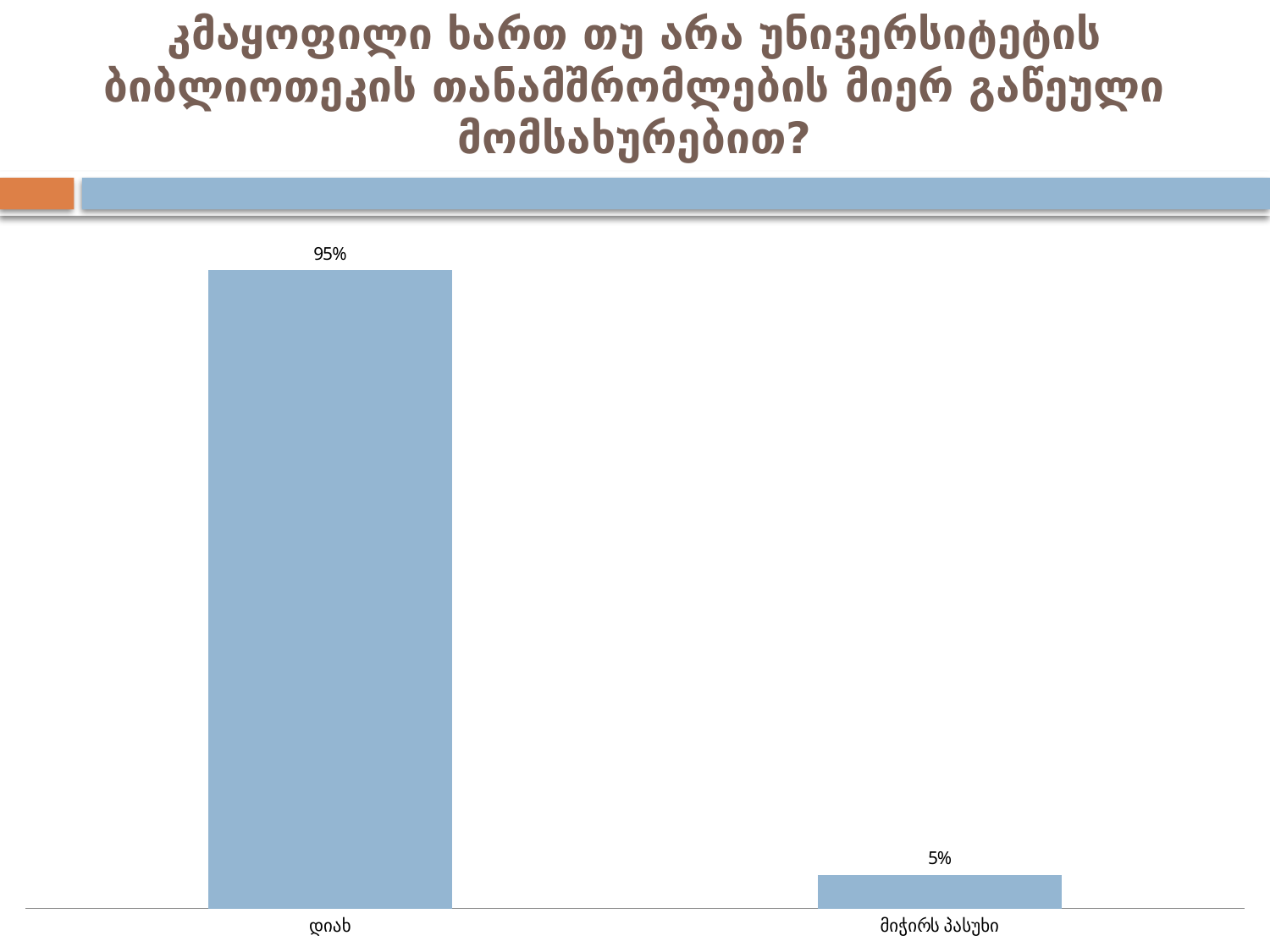
What is the value for დიახ? 95% Which category has the highest value? დიახ Which is larger, the value for დიახ or the value for მიჭირს პასუხი? დიახ What is the total of the two values shown in the chart? 100% Which category has the lowest value? მიჭირს პასუხი Do the values rise or fall from left to right along the x axis? fall How many categories are shown in the chart? 2 What kind of chart is shown on the slide? bar chart What is the value for მიჭირს პასუხი? 5% What colour are the bars in the chart? light blue What is the difference between the values for დიახ and მიჭირს პასუხი? 90% What is the title of the slide? კმაყოფილი ხართ თუ არა უნივერსიტეტის ბიბლიოთეკის თანამშრომლების მიერ გაწეული მომსახურებით?